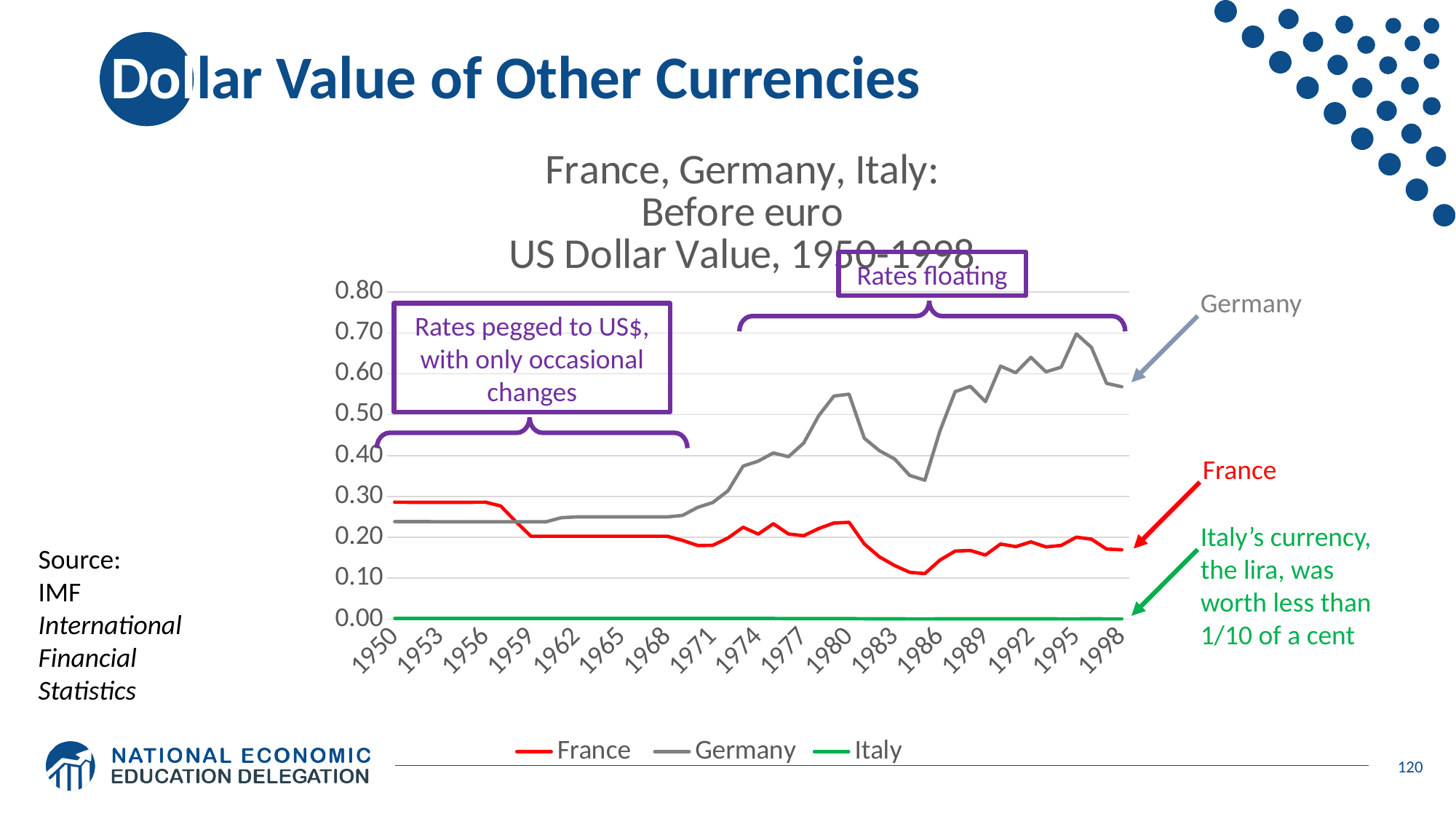
What colour is the line for Italy in the chart? green Does the value for Germany generally rise or fall from 1950 to 1998? rise Which currency has the lowest US dollar value across the whole period shown? Italy Does the value for France generally rise or fall from 1950 to 1998? fall In 1950, which is larger: the value for France or the value for Germany? France Is the value for Germany in 1995 greater or less than 0.60? greater How many series does the chart's legend list? 3 Is the value for Italy in 1998 greater or less than 0.10? less Is the value for France in 1950 greater or less than 0.20? greater What kind of chart is shown on the slide? line chart Which currency has the highest US dollar value in 1998? Germany